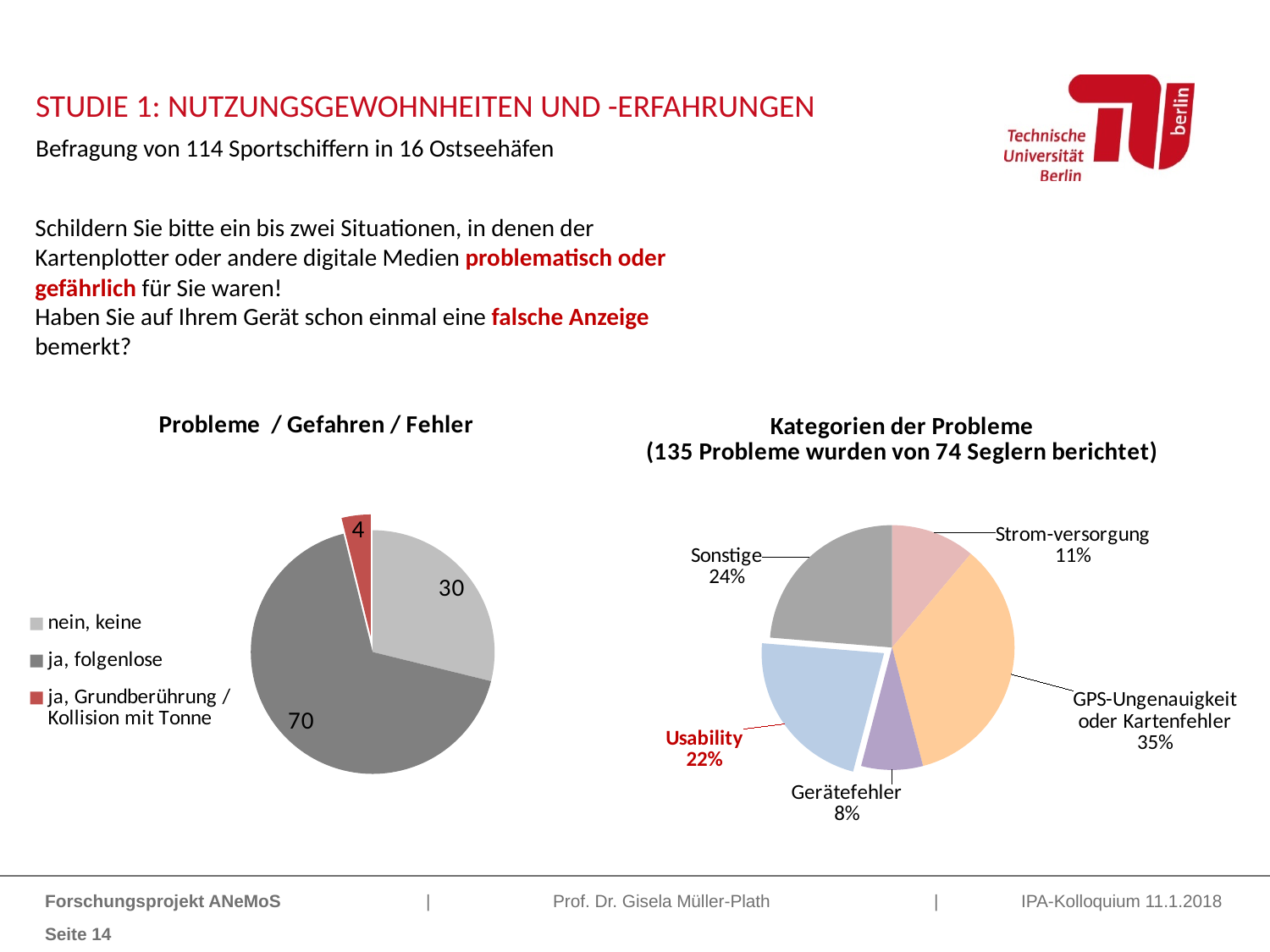
In the right chart 'Kategorien der Probleme', which is larger: 'Sonstige' or 'Strom-versorgung'? Sonstige In the right chart 'Kategorien der Probleme', what share does 'Usability' have? 22% In the left pie chart 'Probleme / Gefahren / Fehler', what is the value for 'nein, keine'? 30 In the left pie chart 'Probleme / Gefahren / Fehler', which category has the largest slice? ja, folgenlose In the left pie chart 'Probleme / Gefahren / Fehler', how many categories does the legend list? 3 In the left pie chart 'Probleme / Gefahren / Fehler', what is the value for 'ja, folgenlose'? 70 In the right chart 'Kategorien der Probleme', which category has the smallest share? Gerätefehler In the left pie chart 'Probleme / Gefahren / Fehler', what is the difference between the values for 'ja, folgenlose' and 'nein, keine'? 40 What kind of chart is the right chart 'Kategorien der Probleme'? Pie chart In the right chart 'Kategorien der Probleme', what share does 'GPS-Ungenauigkeit oder Kartenfehler' have? 35% In the left pie chart 'Probleme / Gefahren / Fehler', what is the value for 'ja, Grundberührung / Kollision mit Tonne'? 4 In the left pie chart 'Probleme / Gefahren / Fehler', which category has the smallest slice? ja, Grundberührung / Kollision mit Tonne